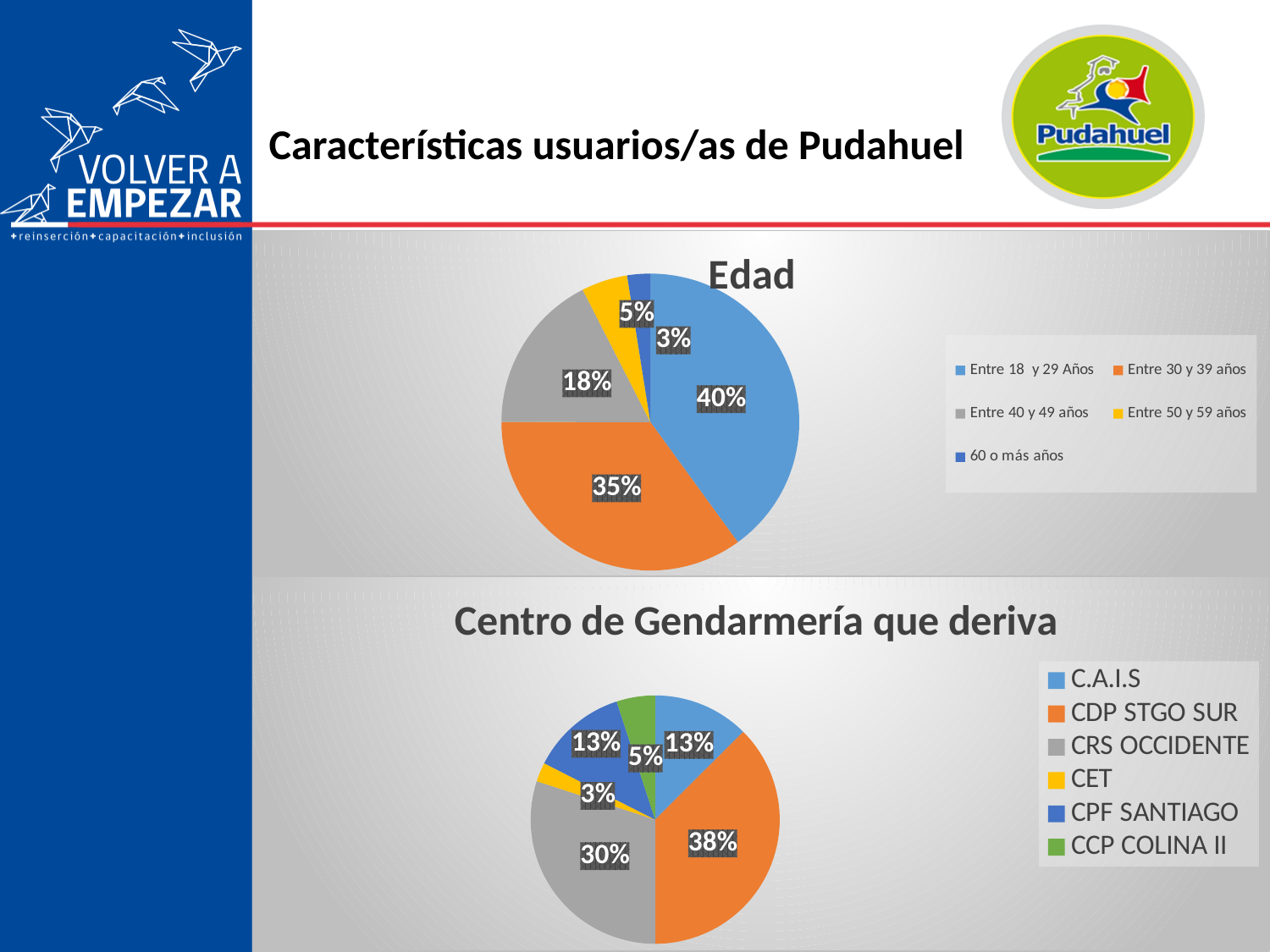
What type of chart is the "Edad" chart? Pie chart In the "Centro de Gendarmería que deriva" chart, which centre has the largest share? CDP STGO SUR How many categories does the legend of the "Centro de Gendarmería que deriva" chart list? 6 In the "Centro de Gendarmería que deriva" chart, which is larger, CRS OCCIDENTE or CPF SANTIAGO? CRS OCCIDENTE In the "Edad" chart, which age group has the smallest share? 60 o más años In the "Centro de Gendarmería que deriva" chart, what share corresponds to CDP STGO SUR? 38% In the "Edad" chart, what percentage corresponds to Entre 40 y 49 años? 18% How many categories does the legend of the "Edad" chart list? 5 In the "Centro de Gendarmería que deriva" chart, what share corresponds to CET? 3% In the "Edad" chart, what is the difference between the shares for Entre 18 y 29 Años and Entre 30 y 39 años? 5% In the "Edad" chart, what share of users are Entre 18 y 29 Años? 40% In the "Edad" chart, which age group has the largest share? Entre 18 y 29 Años